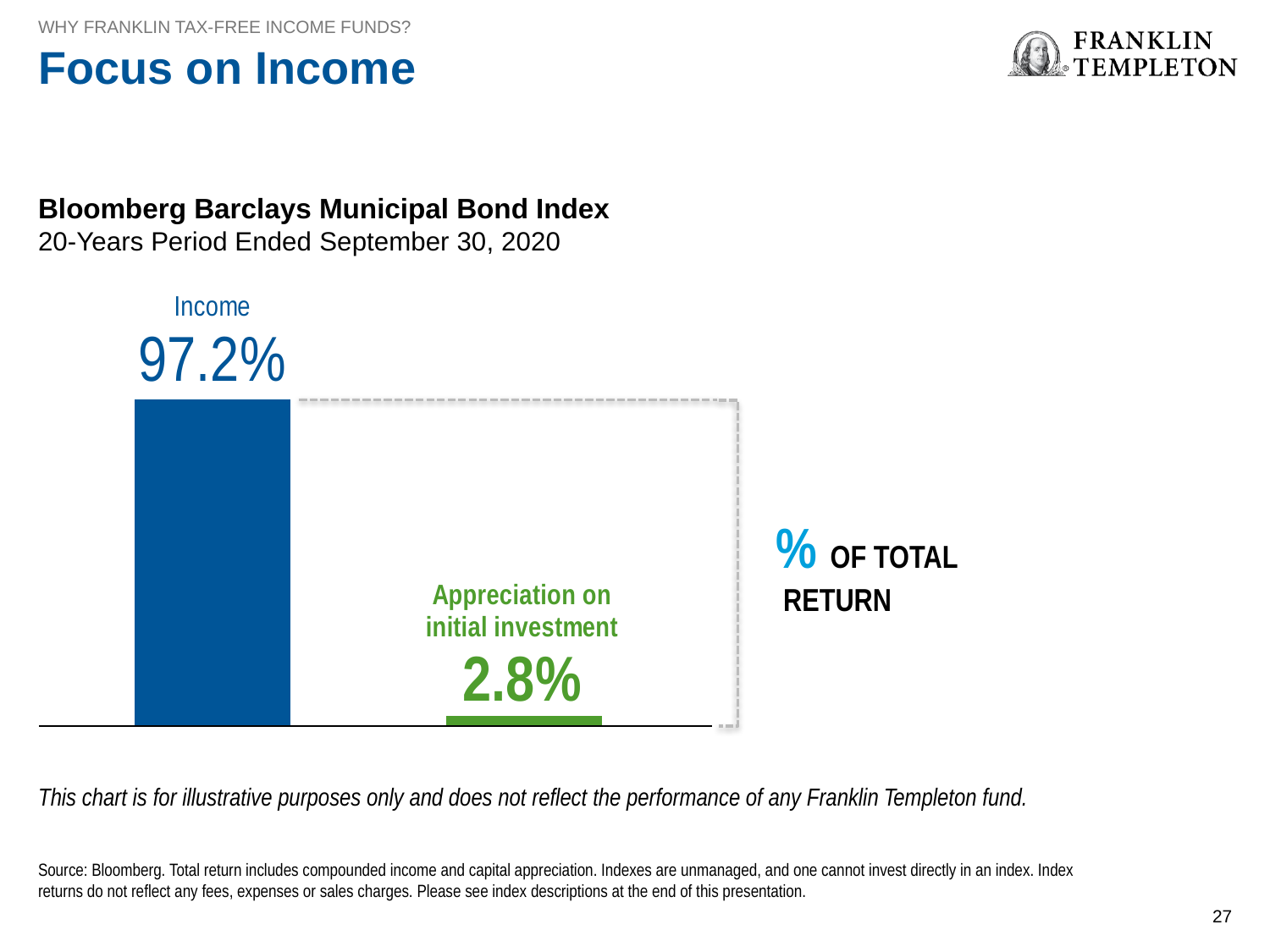
What period does the chart cover? 20-Years Period Ended September 30, 2020 What is the combined total of the Income and Appreciation on initial investment values? 100% What is the difference in percentage points between Income and Appreciation on initial investment? 94.4 Which category accounts for the larger share of total return, Income or Appreciation on initial investment? Income Which category has the highest value in the chart? Income Which index does the chart describe? Bloomberg Barclays Municipal Bond Index What percentage of total return is attributed to Income? 97.2% Which category has the lowest value in the chart? Appreciation on initial investment How many categories are shown in the chart? 2 What kind of chart is shown on the slide? Bar chart What percentage of total return is attributed to Appreciation on initial investment? 2.8%